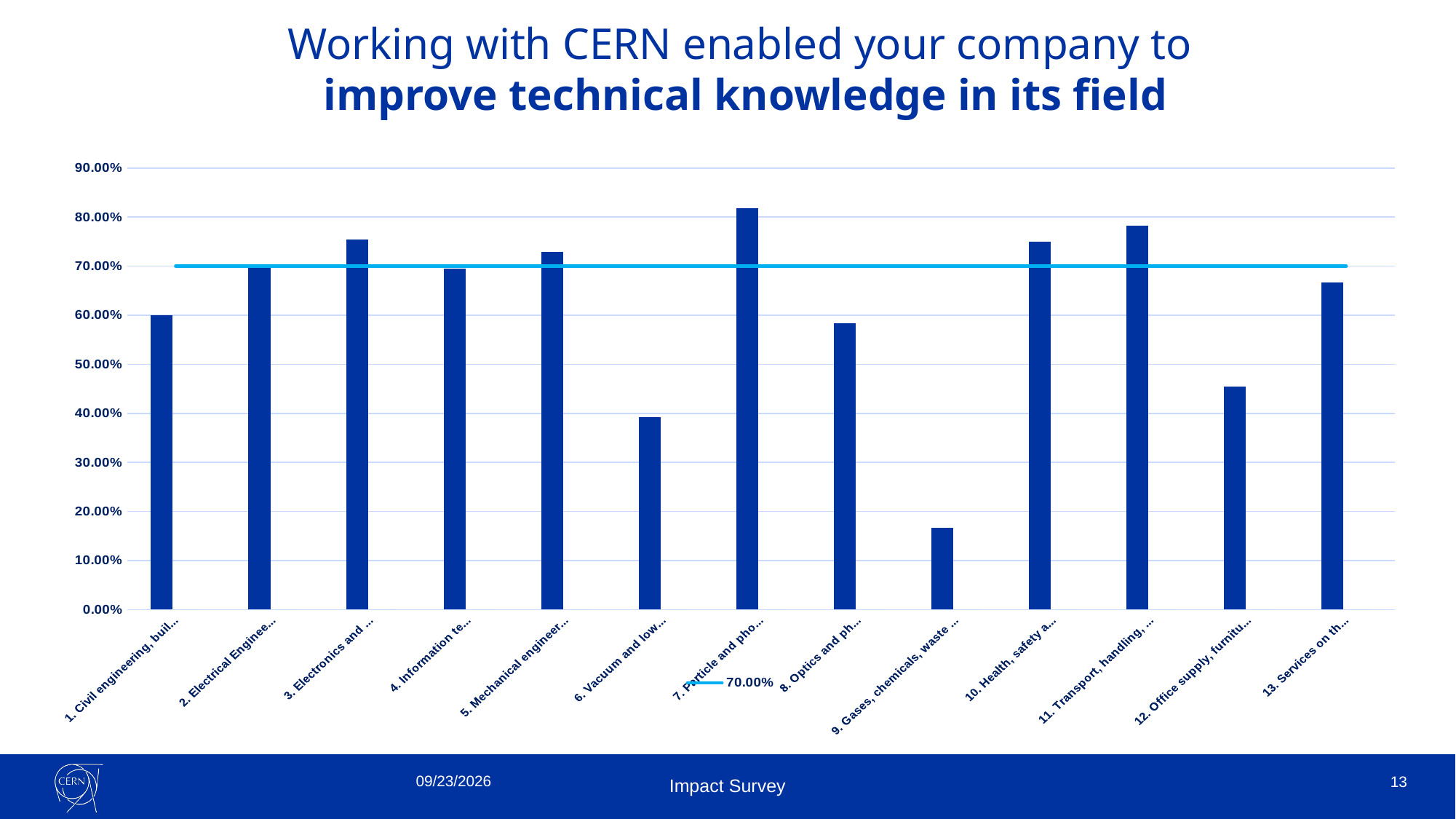
Which category has the lowest bar? 9. Gases, chemicals, waste ... Is the value for 9. Gases, chemicals, waste ... greater or less than 20.00%? less Is the value for 7. Particle and pho... greater or less than 80.00%? greater Which is larger, the value for 10. Health, safety a... or the value for 11. Transport, handling, ...? 11. Transport, handling, ... Which category has the highest bar? 7. Particle and pho... Which is larger, the value for 12. Office supply, furnitu... or the value for 8. Optics and ph...? 8. Optics and ph... Is the value for 11. Transport, handling, ... greater or less than 70.00%? greater What is the value for 1. Civil engineering, buil...? 60.00% How many categories are plotted on the x axis? 13 What kind of chart is shown on the slide? bar and line chart (bars with a horizontal reference line) What value does the horizontal reference line shown in the legend mark? 70.00%